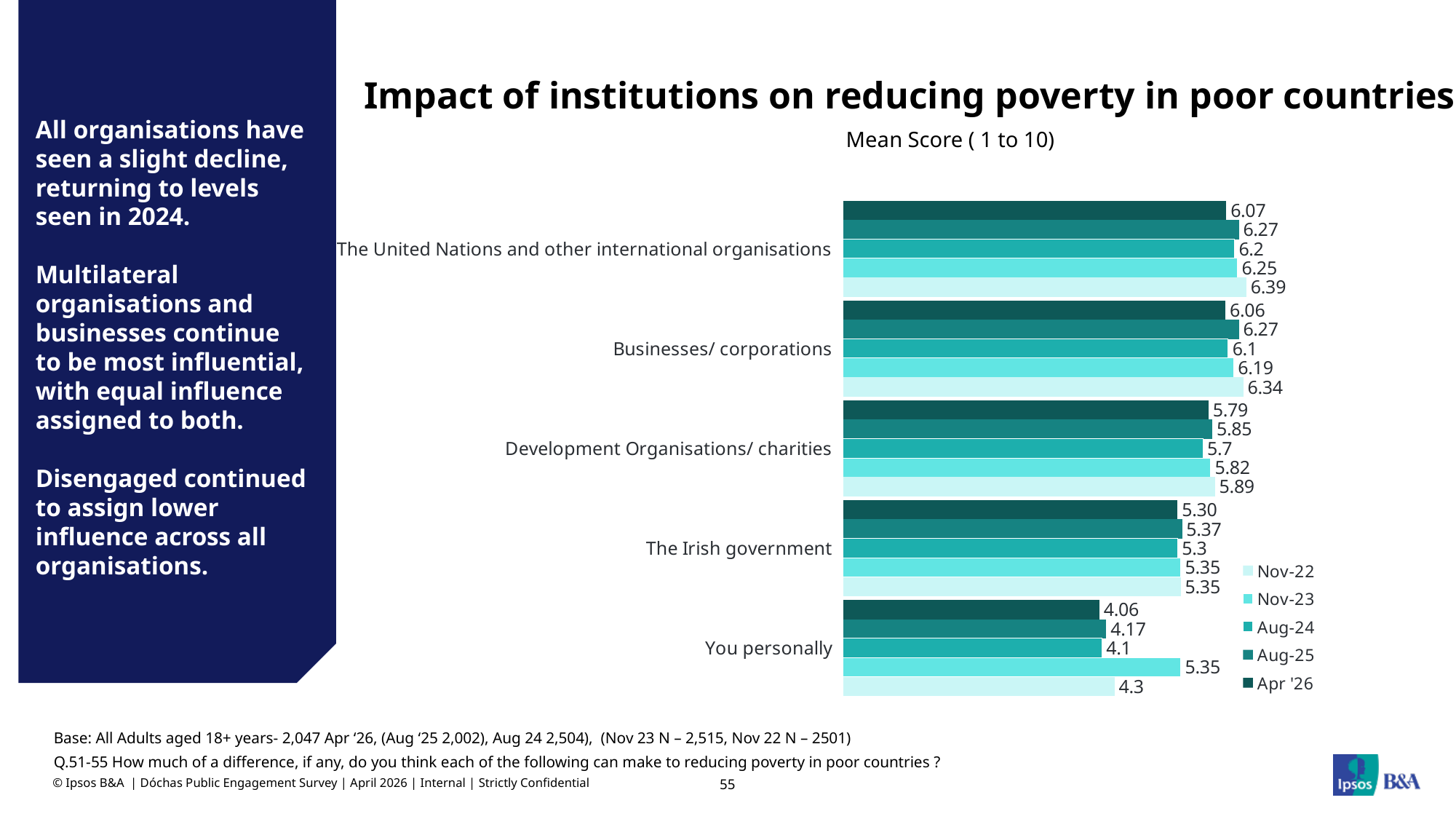
What is the Apr '26 mean score for The United Nations and other international organisations? 6.07 Which category has the lowest Apr '26 mean score? You personally What is the Nov-23 mean score for You personally? 5.35 Which category has the highest Nov-22 mean score? The United Nations and other international organisations What is the subtitle shown under the chart title? Mean Score ( 1 to 10) How many institution categories are plotted on the chart? 5 How many series does the legend list? 5 What is the difference between the Aug-25 and Apr '26 mean scores for Businesses/ corporations? 0.21 What type of chart is shown on the slide? bar chart What is the Aug-25 mean score for Development Organisations/ charities? 5.85 Which is larger for The Irish government: the Aug-25 score or the Apr '26 score? Aug-25 What is the Nov-22 mean score for Businesses/ corporations? 6.34